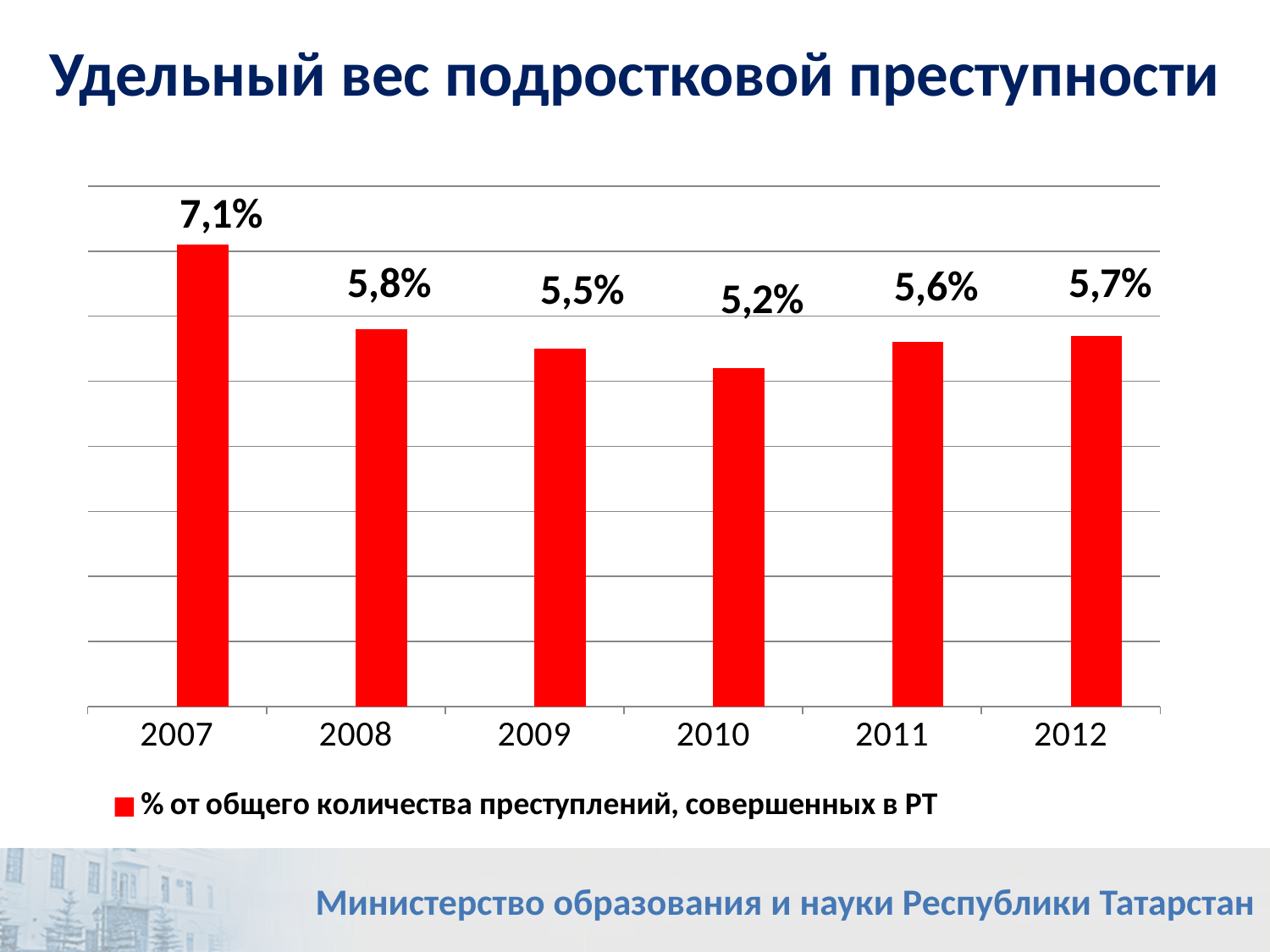
How many series does the legend list? 1 What is the value for 2010? 5,2% What is the value for 2012? 5,7% What is the value for 2007? 7,1% Which year has the lowest value? 2010 What is the difference between the values for 2007 and 2008? 1,3% How many years are shown on the x axis? 6 What is the difference between the values for 2012 and 2010? 0,5% Which year has the highest value? 2007 What is the legend entry for the series? % от общего количества преступлений, совершенных в РТ What kind of chart is shown? bar chart Which is larger, the value for 2009 or the value for 2011? 2011